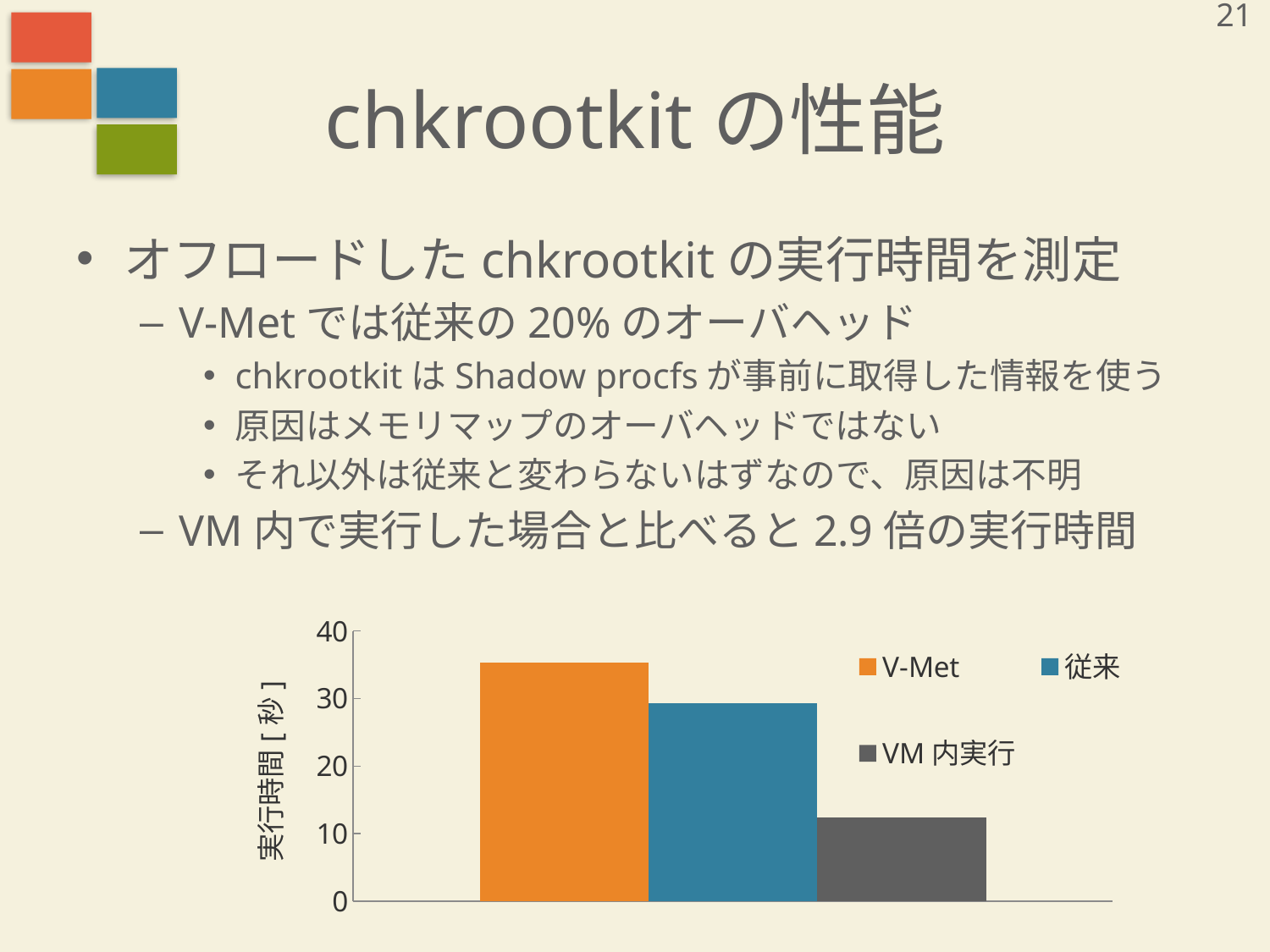
Which series has the lowest execution time in the chart? VM 内実行 What colour is the bar for V-Met in the chart? orange Is the value for VM 内実行 greater or less than 20? less What is the label of the vertical axis of the chart? 実行時間 [秒] Which has a larger execution time, V-Met or 従来? V-Met What kind of chart is shown on the slide? bar chart Is the value for 従来 greater or less than 20? greater Which series has the highest execution time in the chart? V-Met How many series does the chart legend list? 3 Is the value for V-Met greater or less than 30? greater Which has a larger execution time, 従来 or VM 内実行? 従来